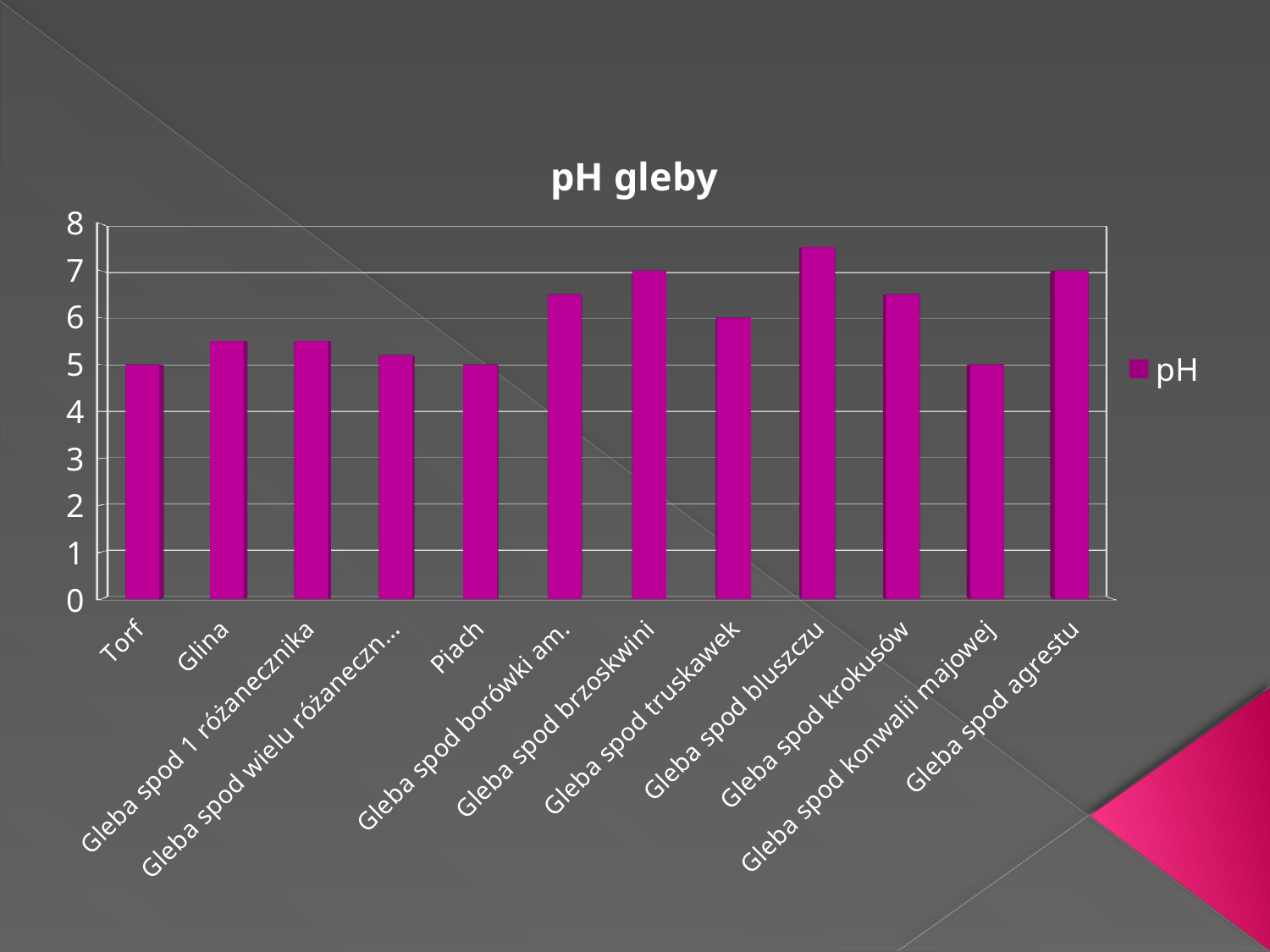
What is the title of the chart? pH gleby How many series does the legend list? 1 What is the pH value for Gleba spod brzoskwini? 7 Which category has the highest pH value? Gleba spod bluszczu What type of chart is shown on the slide? bar chart Is the pH value for Glina greater or less than 5? greater Which has a higher pH value, Gleba spod bluszczu or Gleba spod truskawek? Gleba spod bluszczu What is the pH value for Torf? 5 How many categories are shown on the x axis of the chart? 12 What is the difference between the pH values for Gleba spod agrestu and Piach? 2 Is the pH value for Gleba spod krokusów greater or less than 7? less What is the pH value for Gleba spod truskawek? 6